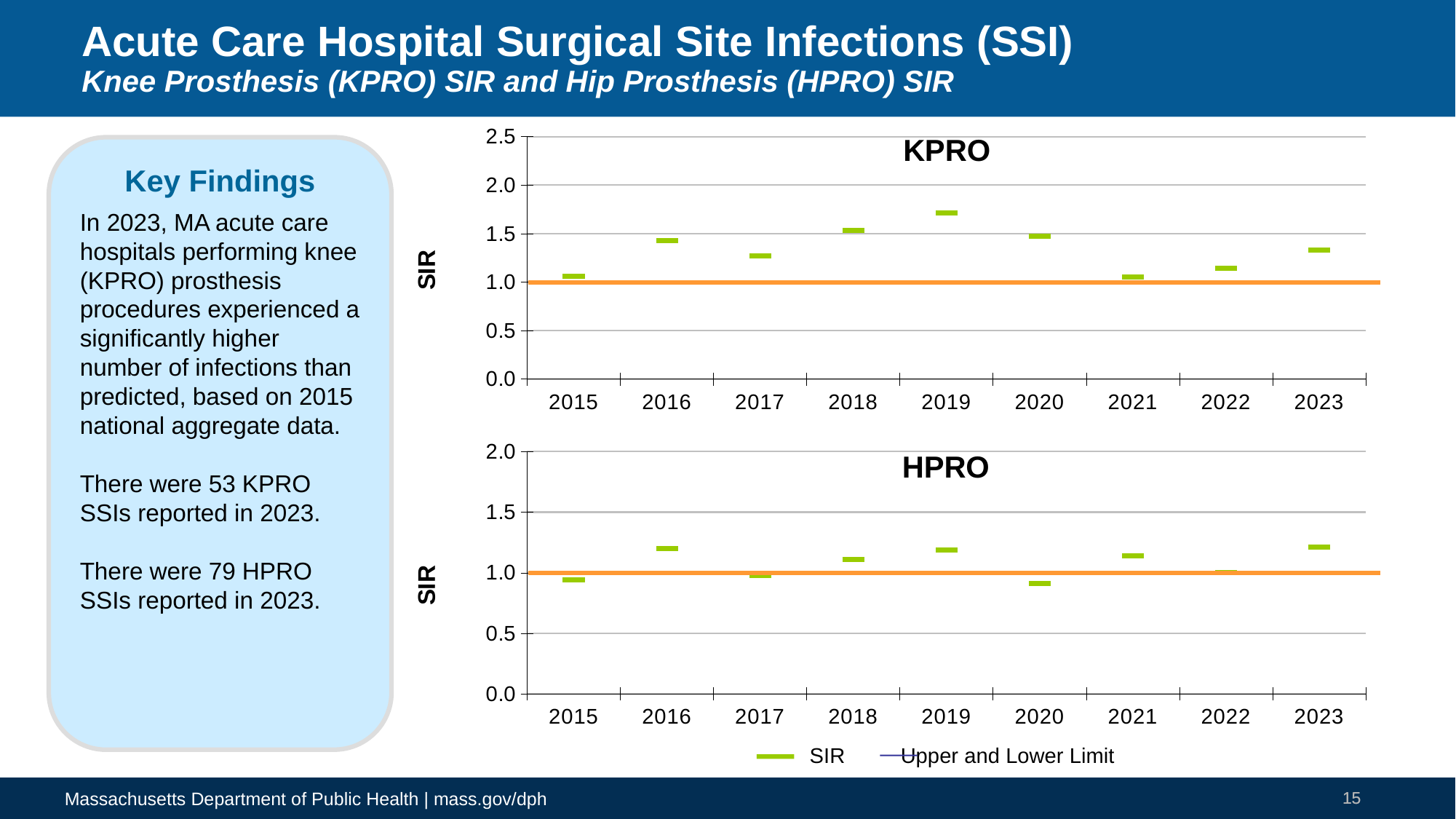
In the HPRO chart, is the SIR for 2020 greater or less than 1.0? less In the KPRO chart, which year has the highest SIR? 2019 In the KPRO chart, which is larger, the SIR for 2019 or the SIR for 2021? 2019 In the KPRO chart, is the SIR for 2016 greater or less than 1.5? less In the KPRO chart, is the SIR for 2019 greater or less than 1.5? greater What is the label on the y axis of the KPRO chart? SIR How many years are shown on the x axis of the HPRO chart? 9 How many series does the legend below the HPRO chart list? 2 In the HPRO chart, which is larger, the SIR for 2016 or the SIR for 2020? 2016 In the KPRO chart, does the SIR rise or fall from 2019 to 2021? fall